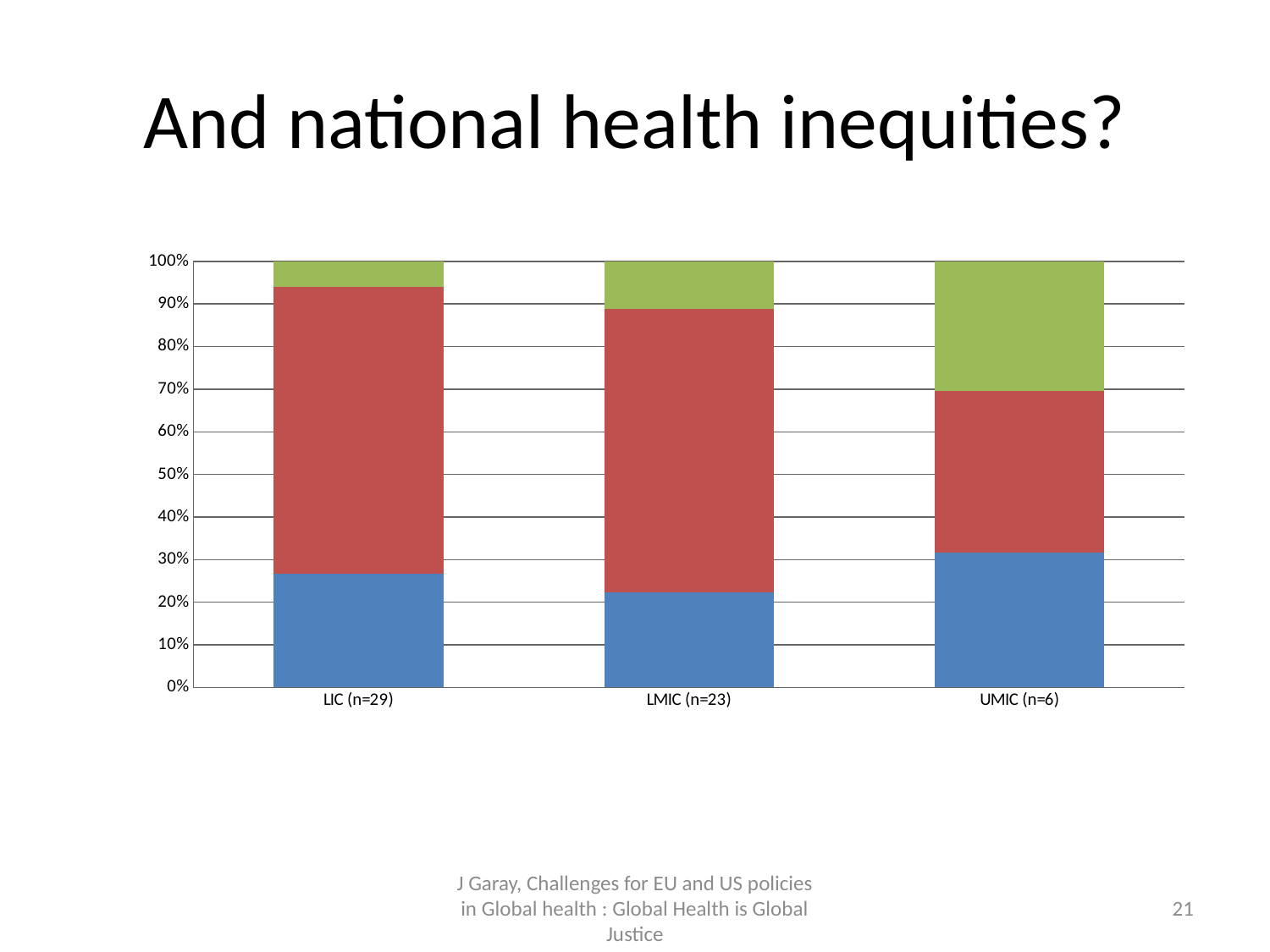
How many categories are shown on the x axis of the chart? 3 Is the blue segment for LMIC (n=23) greater or less than 30%? less Is the green segment for UMIC (n=6) larger or smaller than the green segment for LMIC (n=23)? larger Which category has the smallest red segment? UMIC (n=6) Which category has the largest blue segment? UMIC (n=6) What is the title of the slide containing the chart? And national health inequities? Which category has the largest green segment? UMIC (n=6) What kind of chart is shown on the slide? Stacked bar chart Is the red segment for LIC (n=29) larger or smaller than the red segment for UMIC (n=6)? larger Which category has the smallest blue segment? LMIC (n=23) Is the green segment for LIC (n=29) greater or less than 10%? less What is the highest value shown on the y axis of the chart? 100%